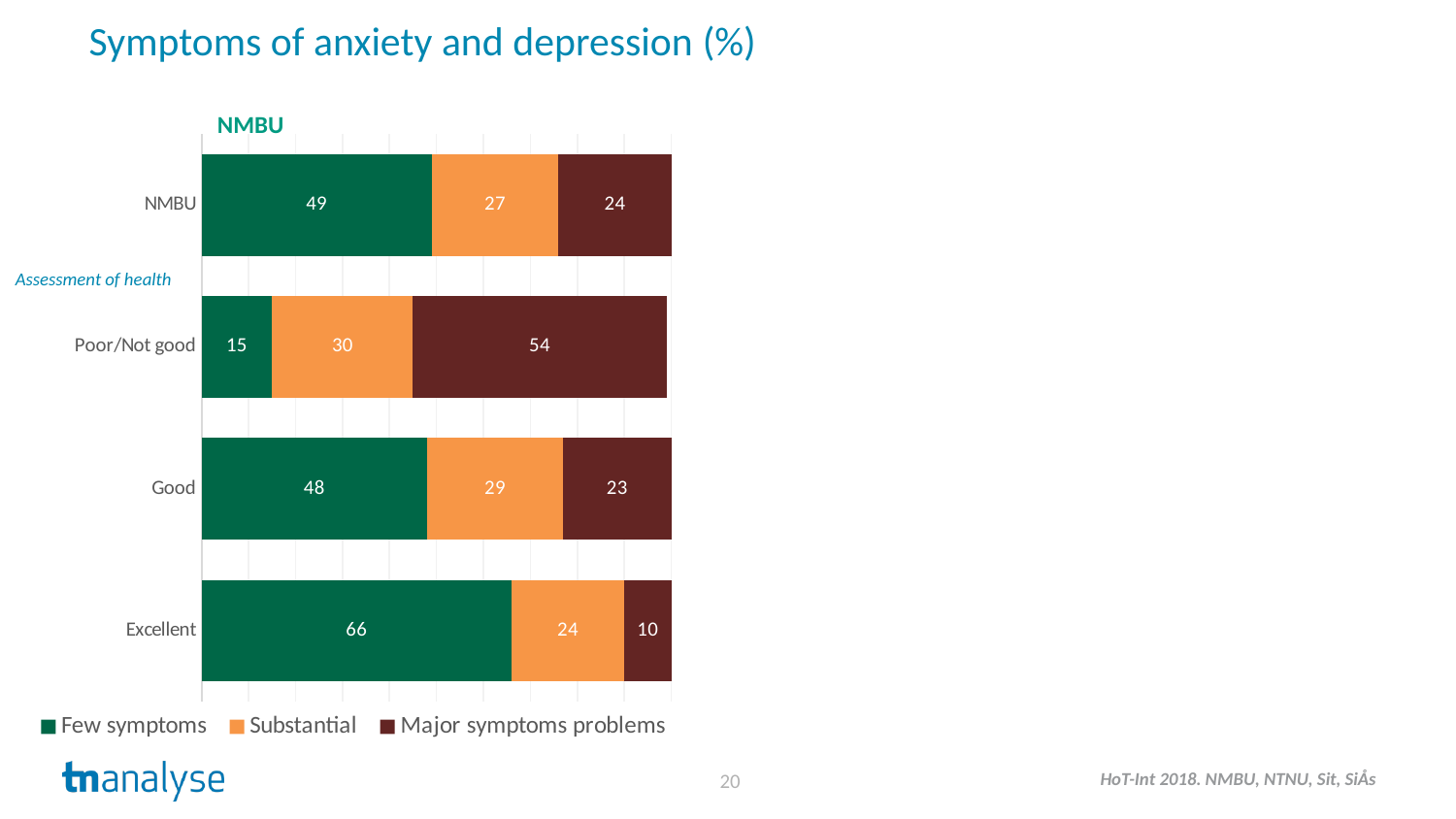
Which is larger: the Major symptoms problems value for NMBU or for Good? NMBU What is the title of the chart? Symptoms of anxiety and depression (%) How many series does the legend list? 3 How many categories are shown on the chart? 4 Which category has the highest value for Few symptoms? Excellent What is the value for Few symptoms in the Excellent category? 66 What is the value for Major symptoms problems in the Poor/Not good category? 54 What is the value for Substantial in the Good category? 29 What is the difference between the Few symptoms values for Excellent and Poor/Not good? 51 What kind of chart is shown on the slide? Stacked bar chart Which category has the lowest value for Major symptoms problems? Excellent What is the total of the stacked bar for the Excellent category? 100